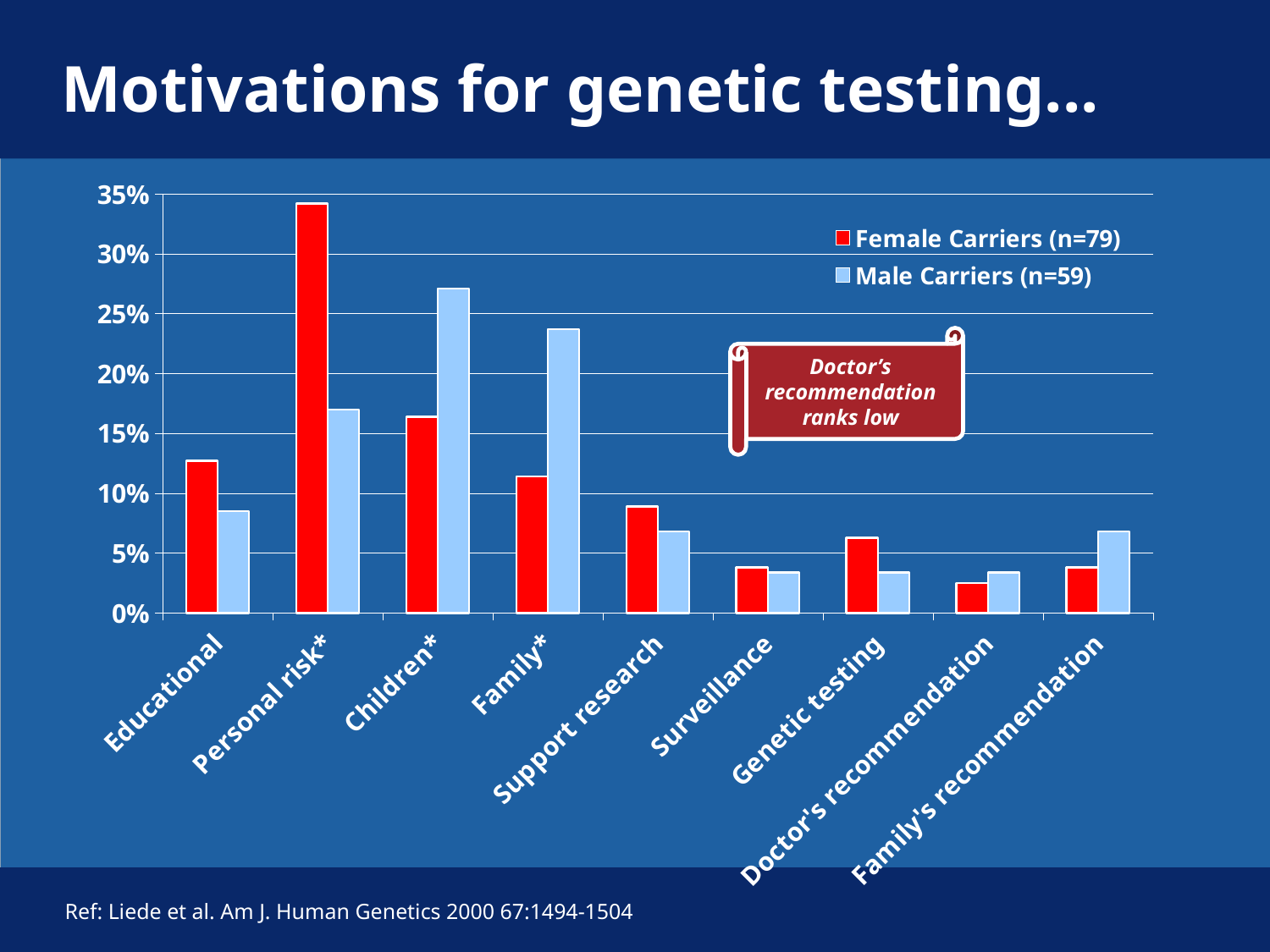
How many series does the legend list? 2 Is the value for Male Carriers for Children* greater or less than 25%? greater For Educational, which series has the larger value, Female Carriers or Male Carriers? Female Carriers (n=79) Is the value for Female Carriers for Doctor's recommendation greater or less than 5%? less What kind of chart is shown on the slide? bar chart Which category has the highest value for Female Carriers (n=79)? Personal risk* What colour are the bars for Female Carriers (n=79)? red How many motivation categories are shown on the x axis? 9 Which category has the lowest value for Female Carriers (n=79)? Doctor's recommendation Is the value for Female Carriers for Personal risk* greater or less than 30%? greater Which category has the highest value for Male Carriers (n=59)? Children* For Children*, which series has the larger value, Female Carriers or Male Carriers? Male Carriers (n=59)